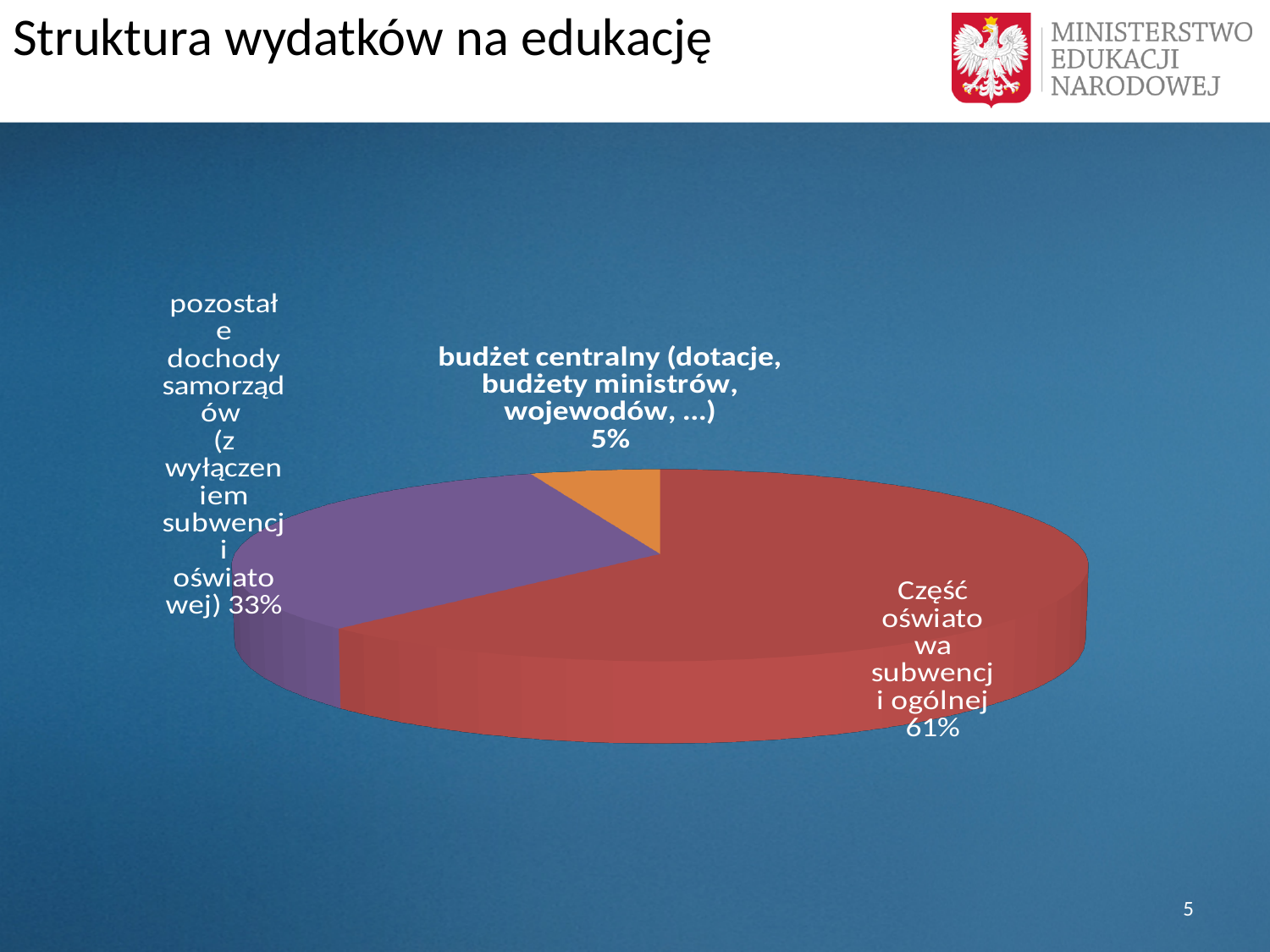
What is the title of the slide containing the pie chart? Struktura wydatków na edukację What colour is the slice for 'Część oświatowa subwencji ogólnej'? red What share of the pie does 'budżet centralny (dotacje, budżety ministrów, wojewodów, ...)' have? 5% What is the difference in percentage points between 'Część oświatowa subwencji ogólnej' and 'pozostałe dochody samorządów (z wyłączeniem subwencji oświatowej)'? 28 percentage points What share of the pie does 'pozostałe dochody samorządów (z wyłączeniem subwencji oświatowej)' have? 33% What kind of chart is shown on the slide? pie chart Which slice of the pie is the largest? Część oświatowa subwencji ogólnej Which is larger: the share for 'pozostałe dochody samorządów' or the share for 'budżet centralny'? pozostałe dochody samorządów How many slices does the pie chart have? 3 Which slice of the pie is the smallest? budżet centralny (dotacje, budżety ministrów, wojewodów, ...) What share of the pie does 'Część oświatowa subwencji ogólnej' have? 61% What is the difference in percentage points between 'pozostałe dochody samorządów (z wyłączeniem subwencji oświatowej)' and 'budżet centralny (dotacje, budżety ministrów, wojewodów, ...)'? 28 percentage points